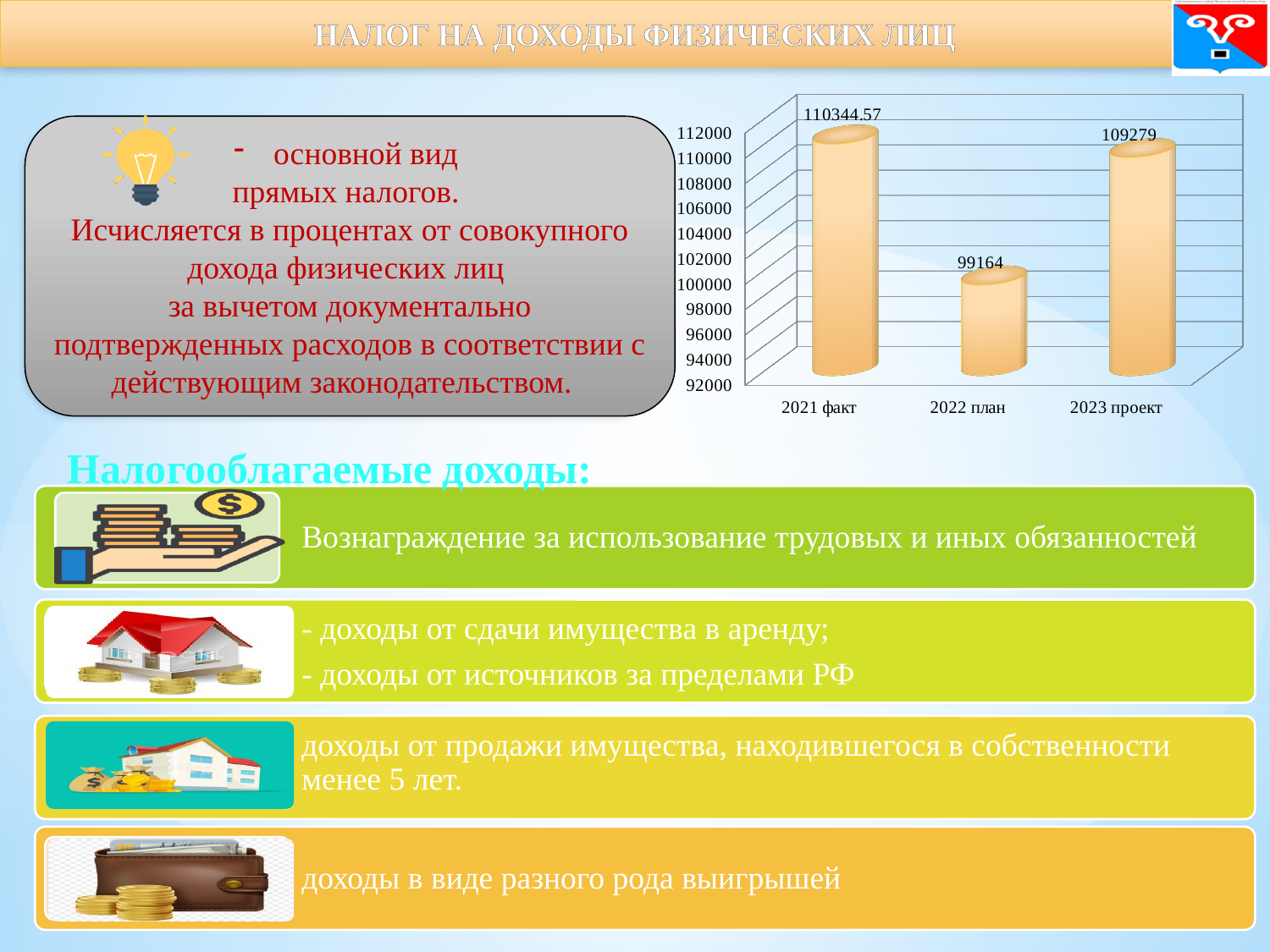
What is the value for 2023 проект? 109279 What is the value for 2022 план? 99164 What is the difference between the values for 2021 факт and 2022 план? 11180.57 Which is larger, the value for 2022 план or the value for 2023 проект? 2023 проект Does the value rise or fall from 2022 план to 2023 проект? rise What is the difference between the values for 2023 проект and 2022 план? 10115 How many categories are shown on the x axis of the chart? 3 Which category has the highest value? 2021 факт Which category has the lowest value? 2022 план What kind of chart is shown on the slide? bar chart Is the value for 2022 план greater or less than 100000? less What is the value for 2021 факт? 110344.57